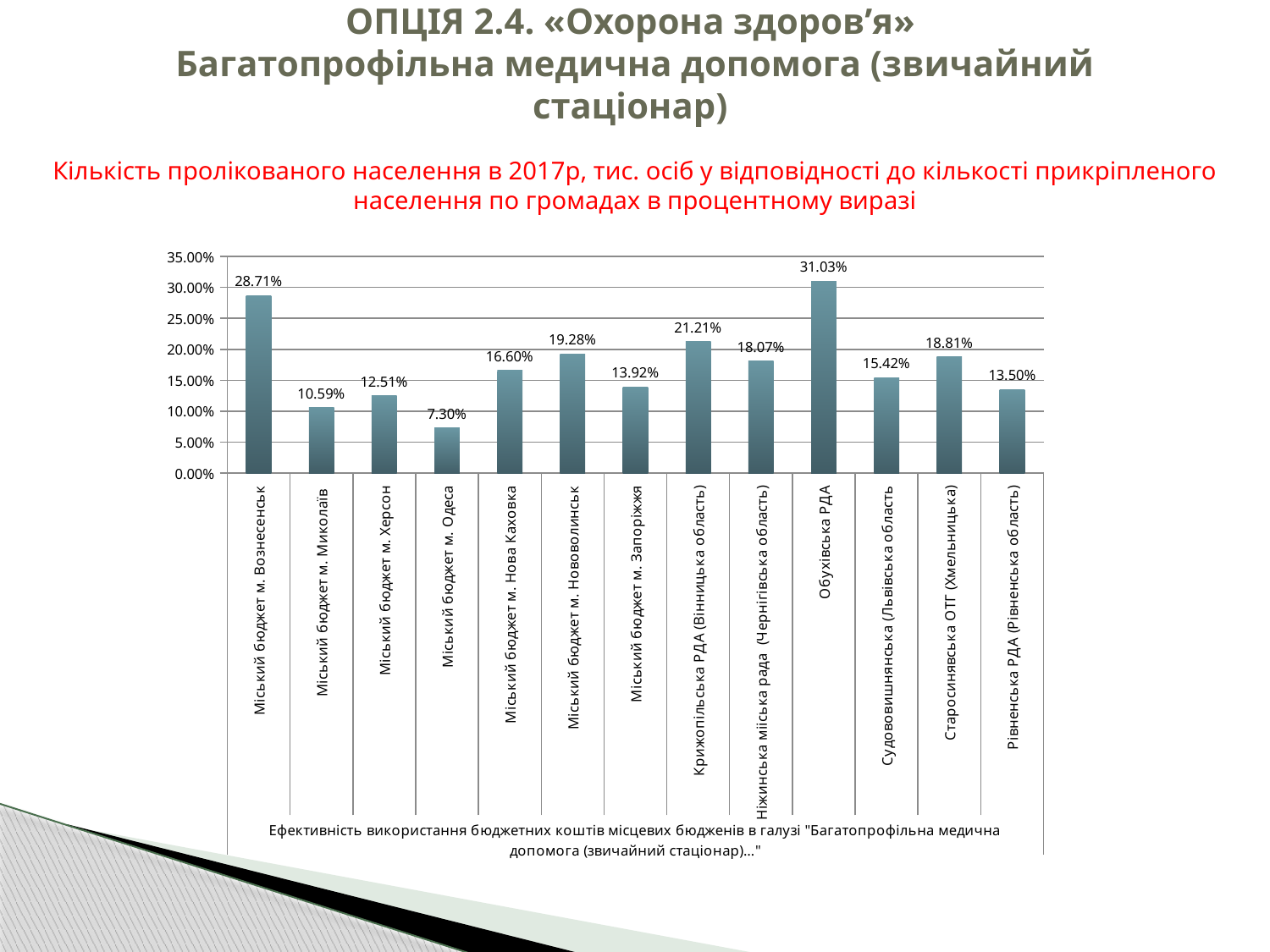
What is the value for Крижопільська РДА (Вінницька область)? 21.21% What is the value for Міський бюджет м. Одеса? 7.30% What is the difference between the values for Крижопільська РДА (Вінницька область) and Ніжинська міська рада (Чернігівська область)? 3.14% How many categories are shown in the chart? 13 Which category has the highest value? Обухівська РДА Is the value for Міський бюджет м. Запоріжжя greater or less than 15.00%? less What is the value for Старосинявська ОТГ (Хмельницька)? 18.81% What is the value for Міський бюджет м. Вознесенськ? 28.71% Which category has the lowest value? Міський бюджет м. Одеса What is the difference between the values for Обухівська РДА and Міський бюджет м. Вознесенськ? 2.32% Which is larger: the value for Міський бюджет м. Нововолинськ or the value for Міський бюджет м. Нова Каховка? Міський бюджет м. Нововолинськ What kind of chart is shown on the slide? bar chart